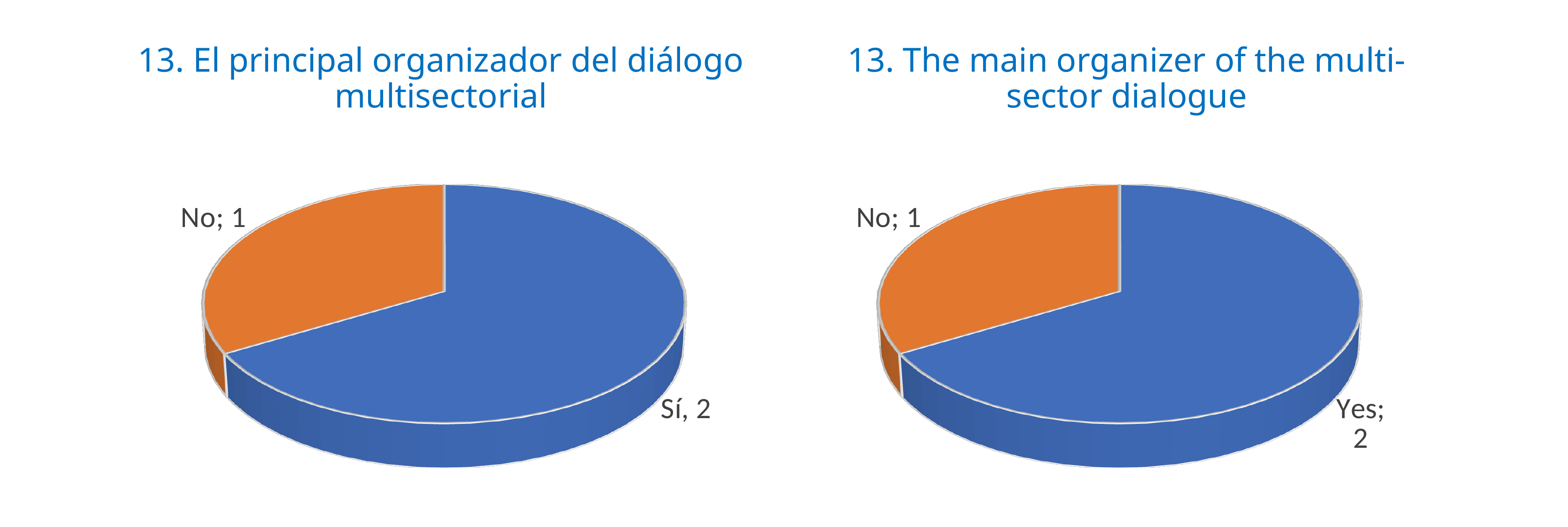
How many slices does the right chart titled "13. The main organizer of the multi-sector dialogue" have? 2 In the left chart titled "13. El principal organizador del diálogo multisectorial", which category has the largest slice? Sí In the right chart titled "13. The main organizer of the multi-sector dialogue", which category has the smallest slice? No What kind of chart is the left chart titled "13. El principal organizador del diálogo multisectorial"? Pie chart In the left chart titled "13. El principal organizador del diálogo multisectorial", what colour is the "No" slice? Orange In the left chart titled "13. El principal organizador del diálogo multisectorial", what is the value for "No"? 1 In the right chart titled "13. The main organizer of the multi-sector dialogue", what is the difference between the values for "Yes" and "No"? 1 In the right chart titled "13. The main organizer of the multi-sector dialogue", what is the value for "No"? 1 In the right chart titled "13. The main organizer of the multi-sector dialogue", what share of the total does the "No" slice represent? 1/3 In the right chart titled "13. The main organizer of the multi-sector dialogue", what is the value for "Yes"? 2 In the left chart titled "13. El principal organizador del diálogo multisectorial", what is the value for "Sí"? 2 In the left chart titled "13. El principal organizador del diálogo multisectorial", which is larger, "Sí" or "No"? Sí